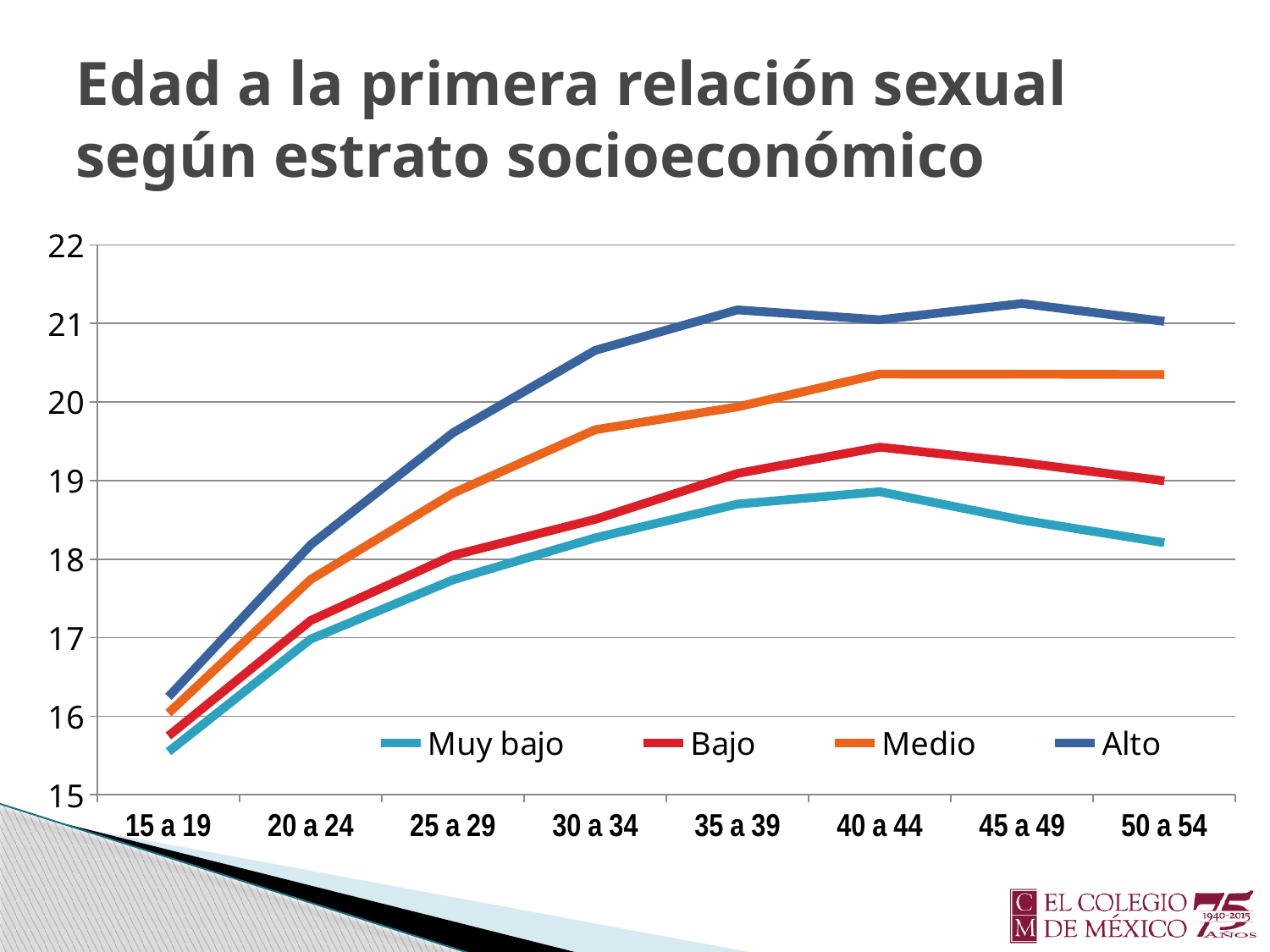
Is the value for Alto in the 15 a 19 group greater or less than 17? less Does the Muy bajo line rise or fall from 15 a 19 to 35 a 39? rise How many age-group categories are shown on the x axis? 8 How many series does the legend list? 4 Is the value for Alto in the 35 a 39 group greater or less than 21? greater Which series has the highest value in the 40 a 44 group? Alto What is the title of the chart on the slide? Edad a la primera relación sexual según estrato socioeconómico What kind of chart is shown on the slide? line chart Which series has the lowest value in the 15 a 19 group? Muy bajo Is the value for Bajo in the 20 a 24 group greater or less than 18? less In the 30 a 34 group, which is larger, Medio or Bajo? Medio